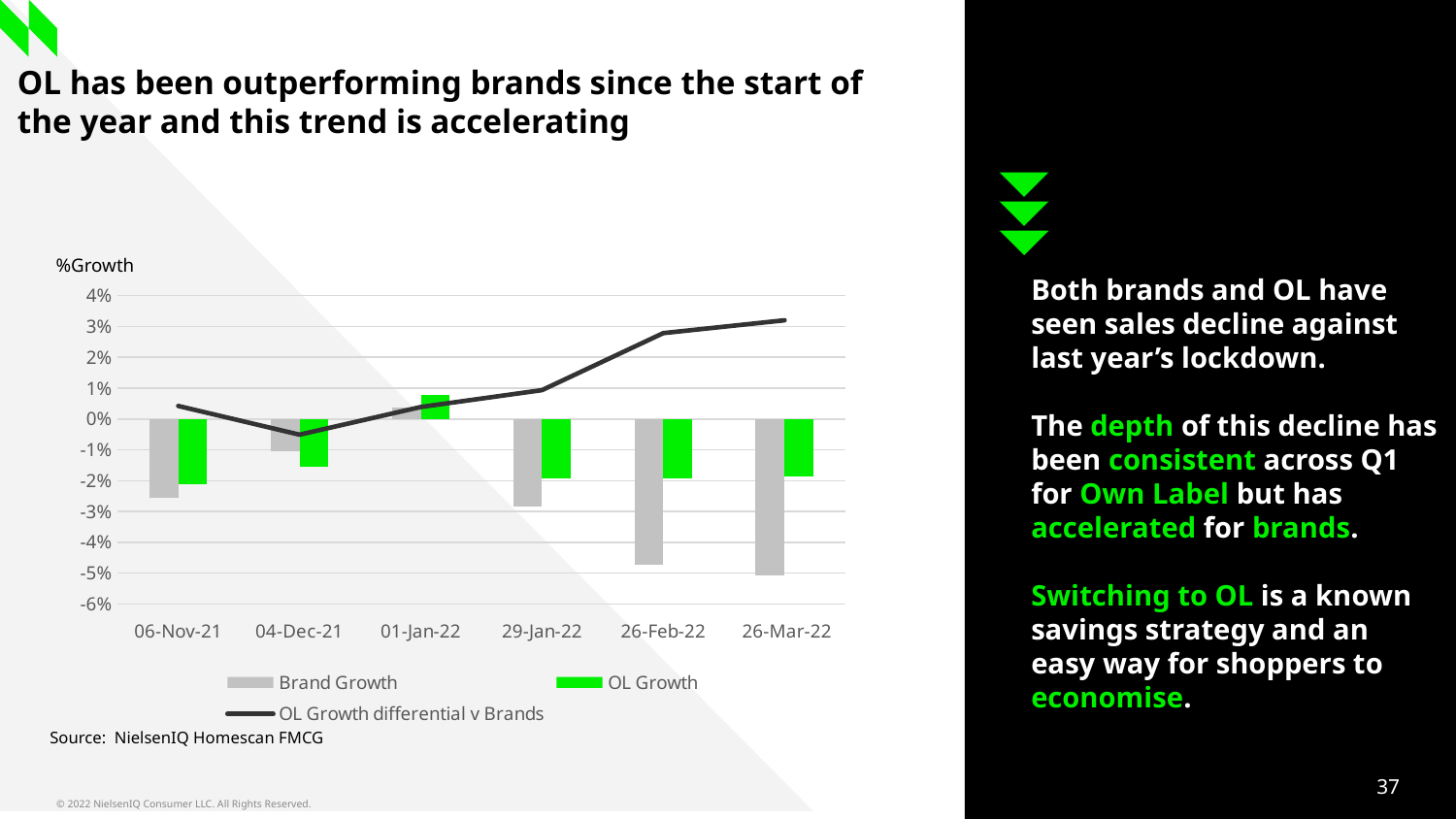
Is the OL Growth differential v Brands value for 26-Feb-22 greater or less than 2%? greater Is the Brand Growth value for 26-Feb-22 greater or less than -4%? less Which date has the highest OL Growth? 01-Jan-22 Is the OL Growth value for 01-Jan-22 greater or less than 0%? greater Does the OL Growth differential v Brands line rise or fall from 01-Jan-22 to 26-Mar-22? Rise Which date has the lowest value for OL Growth differential v Brands? 04-Dec-21 At 26-Feb-22, which is larger, Brand Growth or OL Growth? OL Growth What is the label on the vertical axis of the chart? %Growth Which date has the highest value for OL Growth differential v Brands? 26-Mar-22 How many series does the chart legend list? 3 How many dates are shown on the x axis of the chart? 6 What kind of chart is shown on the slide? Bar chart with a line